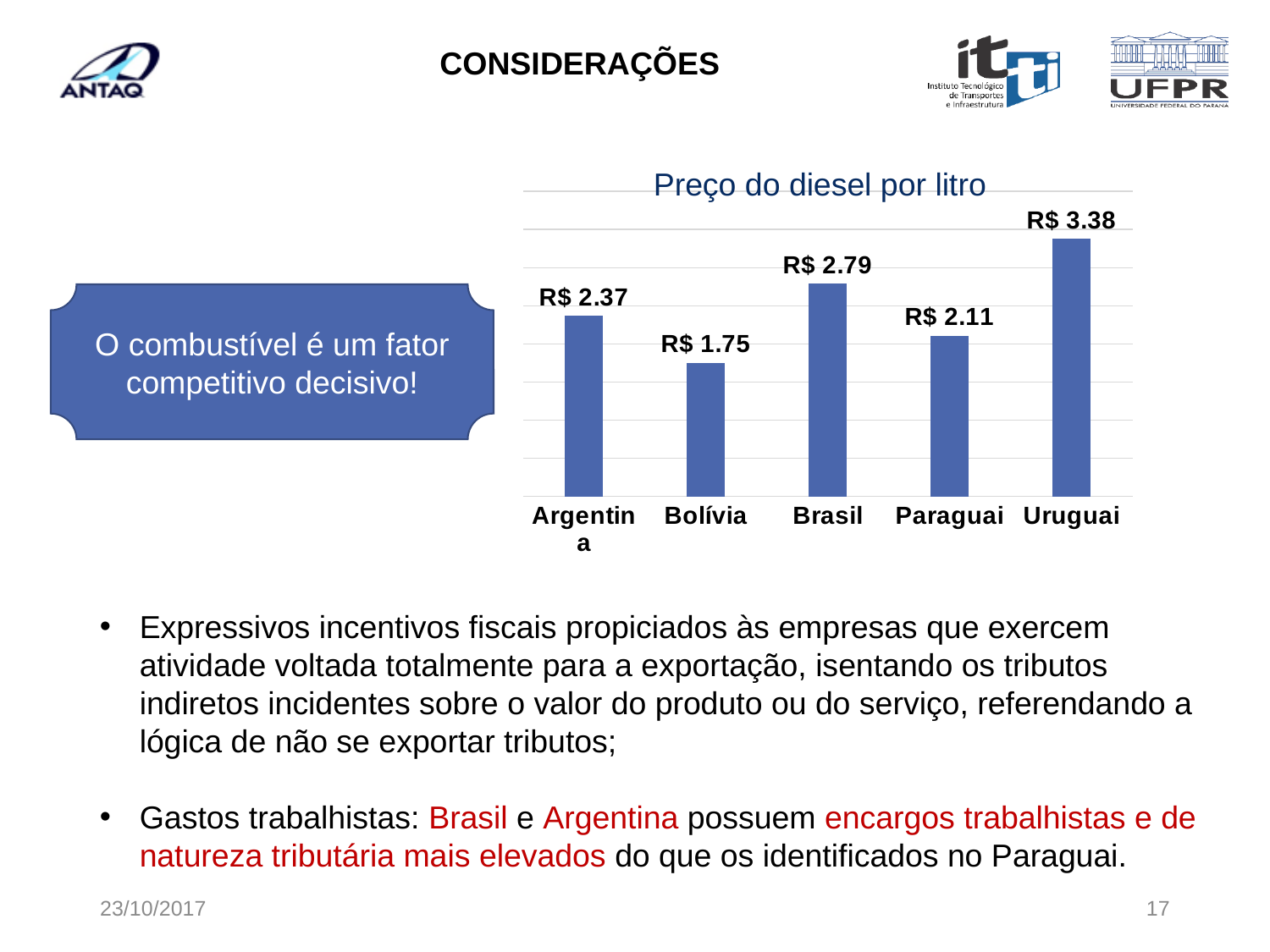
Which country has the lowest diesel price per litre? Bolívia Which country has the highest diesel price per litre? Uruguai What is the diesel price per litre for Brasil? R$ 2.79 How many countries are shown in the chart? 5 What is the diesel price per litre for Bolívia? R$ 1.75 What is the diesel price per litre for Paraguai? R$ 2.11 What is the difference in diesel price per litre between Uruguai and Bolívia? R$ 1.63 What type of chart is shown on the slide? Bar chart What is the diesel price per litre for Uruguai? R$ 3.38 What is the difference in diesel price per litre between Brasil and Argentina? R$ 0.42 What is the title of the chart? Preço do diesel por litro Which has a higher diesel price per litre, Argentina or Paraguai? Argentina